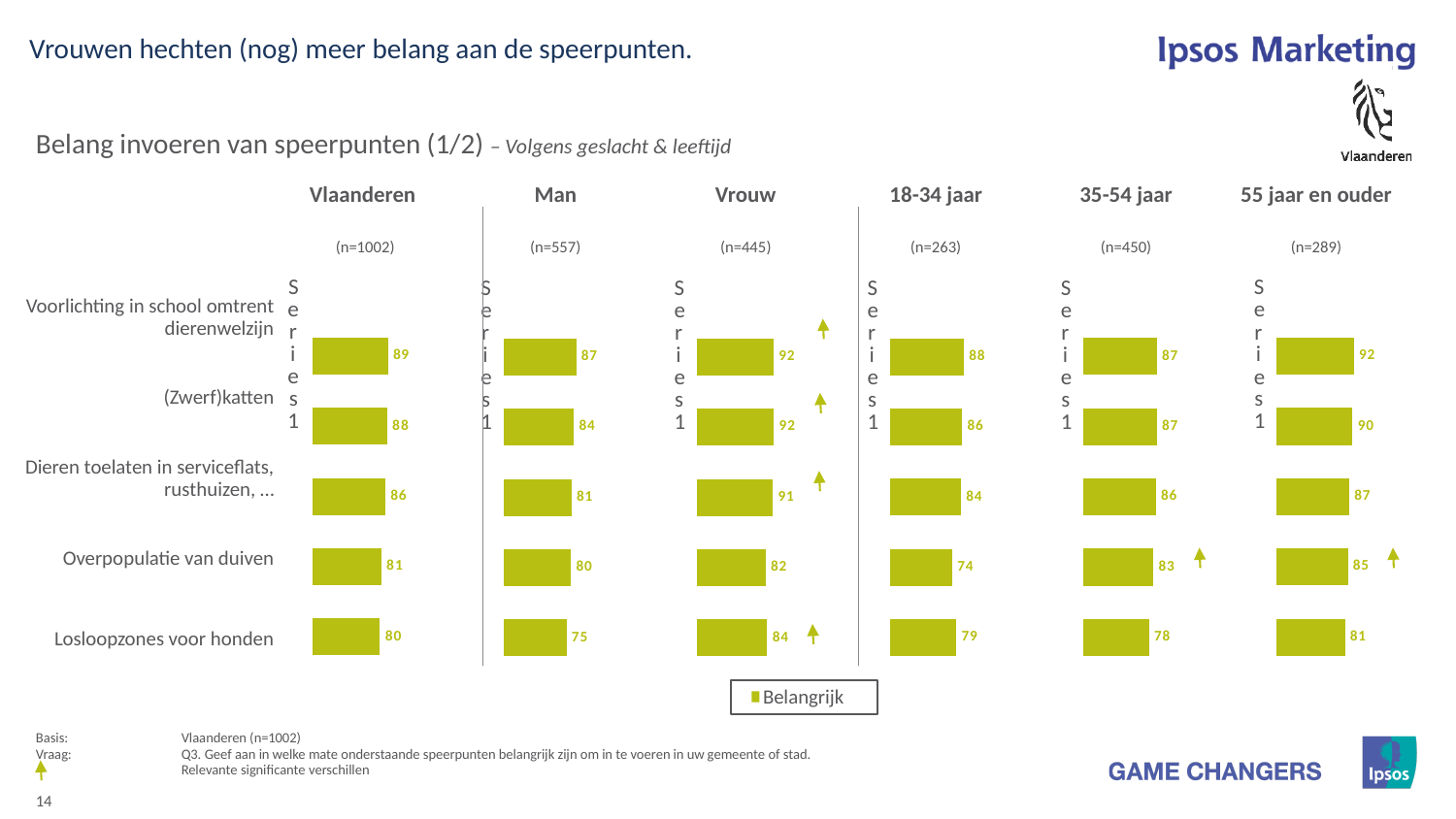
In the 18-34 jaar chart, which category has the lowest value? Overpopulatie van duiven In the Man chart, what is the difference between the values for Voorlichting in school omtrent dierenwelzijn and Losloopzones voor honden? 12 In the Vrouw chart, what is the value for Overpopulatie van duiven? 82 In the Man chart, what is the value for (Zwerf)katten? 84 In the Vlaanderen chart, what is the value for Losloopzones voor honden? 80 What kind of chart is the Vlaanderen chart? bar chart For Dieren toelaten in serviceflats, rusthuizen, …, which is larger: the value in the Man chart or the value in the Vrouw chart? Vrouw What is the legend entry shown below the charts? Belangrijk How many series does the legend list? 1 How many categories are shown in the 35-54 jaar chart? 5 What is the sample size (n) shown for the Vrouw chart? n=445 In the 55 jaar en ouder chart, which category has the highest value? Voorlichting in school omtrent dierenwelzijn